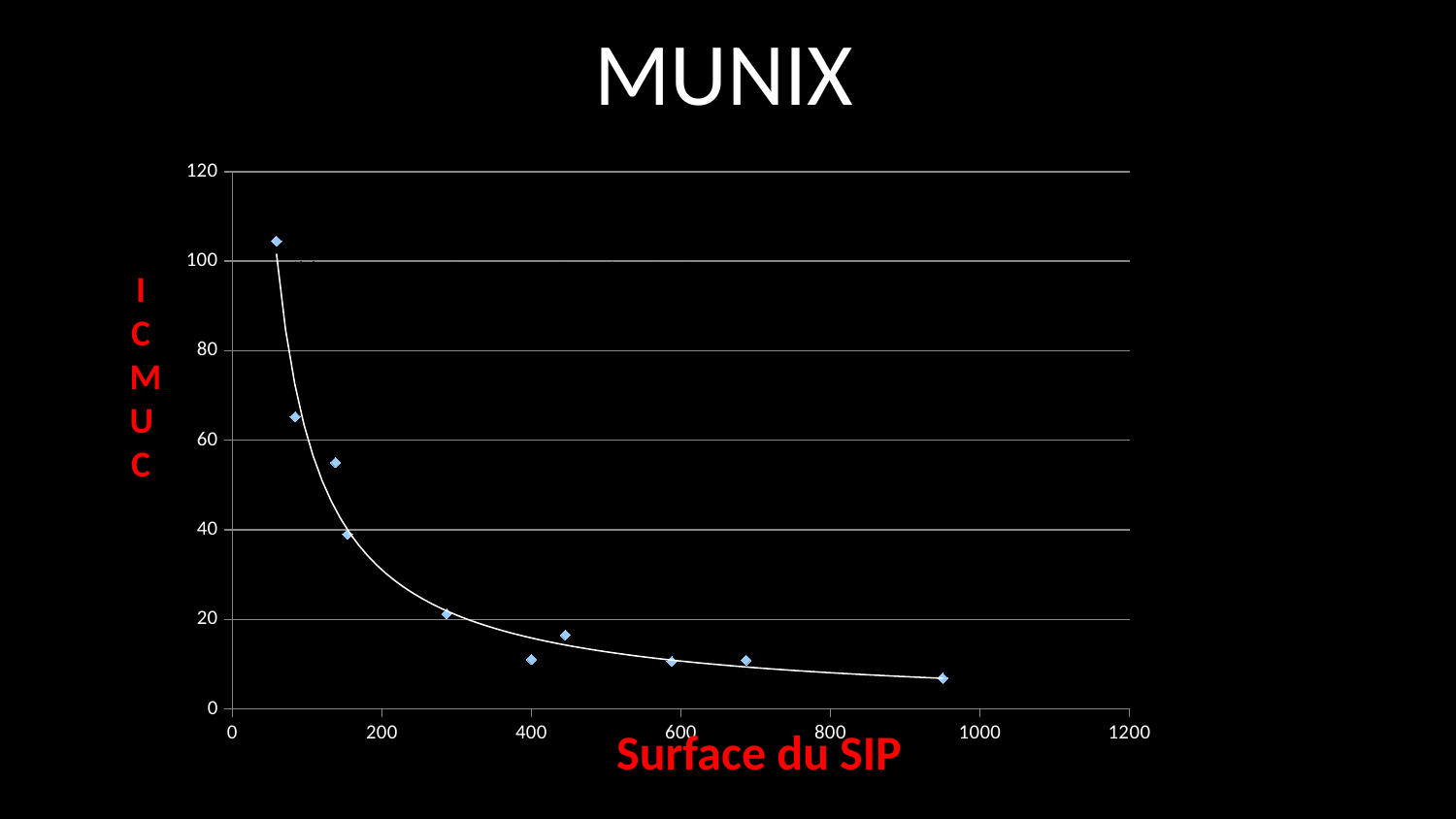
How many data points are plotted on the chart? 10 As Surface du SIP increases, do the ICMUC values rise or fall? fall Is the ICMUC value of the leftmost point (smallest Surface du SIP) greater or less than 80? greater Is the ICMUC value of the rightmost point (largest Surface du SIP) greater or less than 20? less What is the title of the chart? MUNIX What kind of chart is shown on the slide? scatter chart Is the ICMUC value of the third point from the left greater or less than 60? less Which has the larger ICMUC value: the leftmost point or the rightmost point? the leftmost point What is the label of the x axis? Surface du SIP Does the point with the highest ICMUC value have the smallest or the largest Surface du SIP? smallest